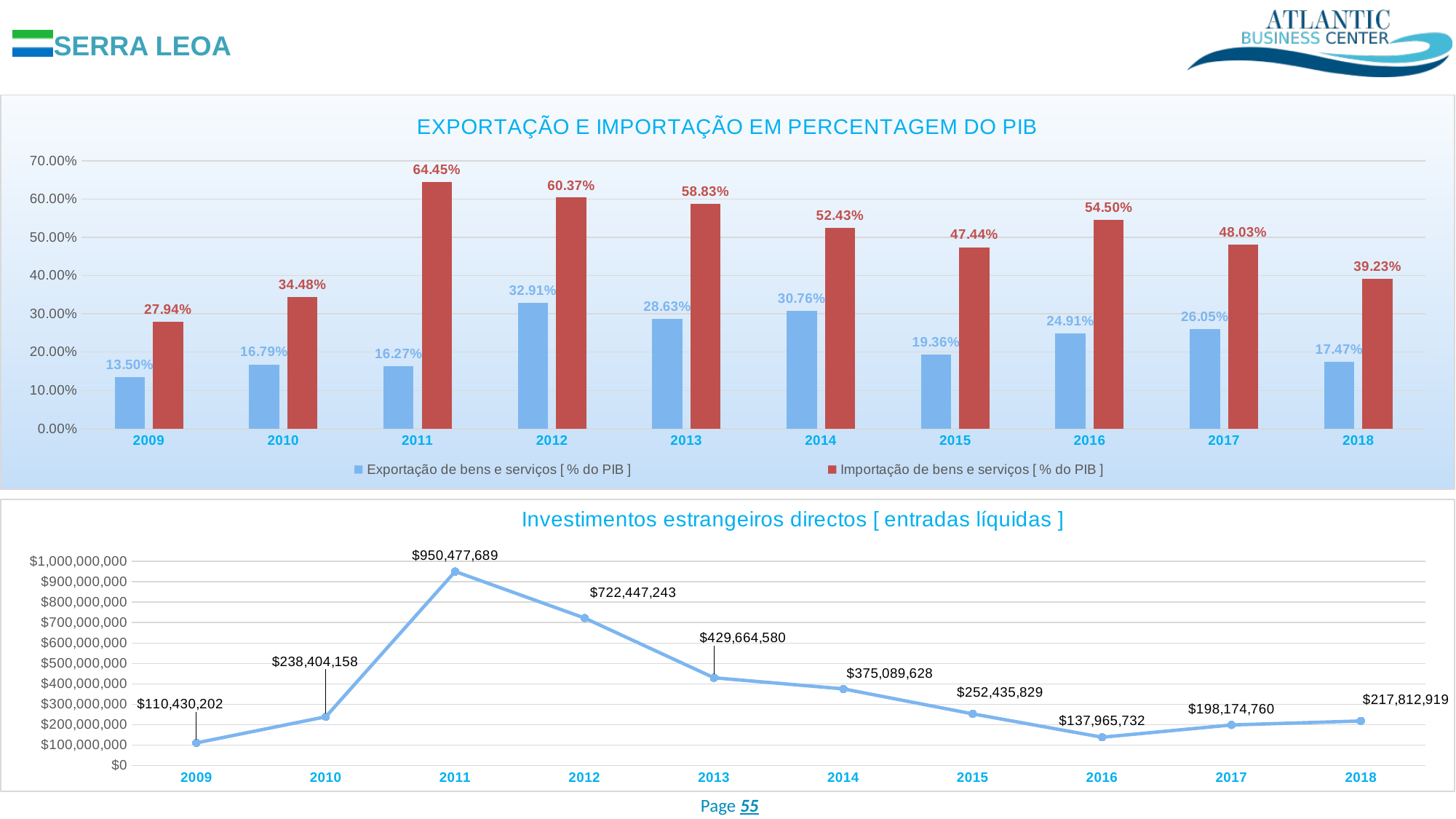
In the chart 'Investimentos estrangeiros directos [ entradas líquidas ]', what is the value for 2013? $429,664,580 In the chart 'EXPORTAÇÃO E IMPORTAÇÃO EM PERCENTAGEM DO PIB', how many series does the legend list? 2 In the chart 'Investimentos estrangeiros directos [ entradas líquidas ]', which year has the lowest value? 2009 In the chart 'EXPORTAÇÃO E IMPORTAÇÃO EM PERCENTAGEM DO PIB', what is the value of Importação de bens e serviços for 2011? 64.45% What kind of chart is 'Investimentos estrangeiros directos [ entradas líquidas ]'? Line chart In the chart 'EXPORTAÇÃO E IMPORTAÇÃO EM PERCENTAGEM DO PIB', which year has the highest Exportação de bens e serviços value? 2012 In the chart 'EXPORTAÇÃO E IMPORTAÇÃO EM PERCENTAGEM DO PIB', what is the value of Exportação de bens e serviços for 2014? 30.76% In the chart 'Investimentos estrangeiros directos [ entradas líquidas ]', what is the difference between the 2011 and 2012 values? $228,030,446 In the chart 'EXPORTAÇÃO E IMPORTAÇÃO EM PERCENTAGEM DO PIB', what is the difference between Importação and Exportação in 2011? 48.18% In the chart 'EXPORTAÇÃO E IMPORTAÇÃO EM PERCENTAGEM DO PIB', which year has the lowest Importação de bens e serviços value? 2009 What kind of chart is 'EXPORTAÇÃO E IMPORTAÇÃO EM PERCENTAGEM DO PIB'? Bar chart In the chart 'Investimentos estrangeiros directos [ entradas líquidas ]', which year has the highest value? 2011